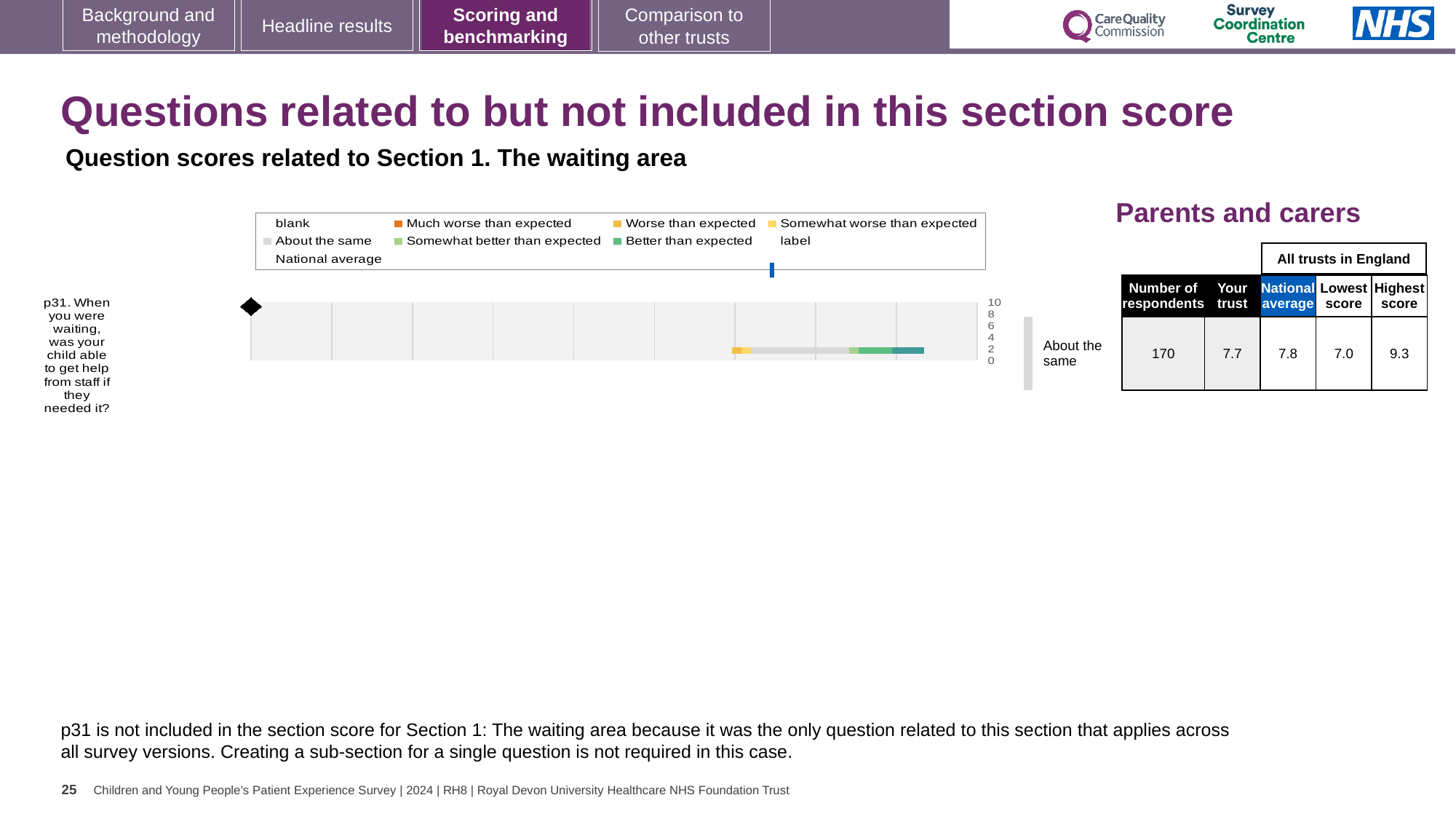
In the table next to the chart, what is the lowest score among all trusts in England for p31? 7.0 How many questions (categories) are plotted in the chart? 1 In the table next to the chart, what is the 'Your trust' score for p31? 7.7 Which question is plotted in the chart? p31. When you were waiting, was your child able to get help from staff if they needed it? In the table next to the chart, which is larger for p31: the 'Your trust' score or the national average? National average In the table next to the chart, what is the national average score for p31? 7.8 In the table next to the chart, what is the number of respondents for p31? 170 What benchmark label is shown to the right of the bar for p31? About the same What kind of chart is shown on the slide? bar chart In the table next to the chart, what is the highest score among all trusts in England for p31? 9.3 What is the highest value shown on the chart's axis? 10 In the table next to the chart, what is the difference between the highest score and the lowest score for p31? 2.3